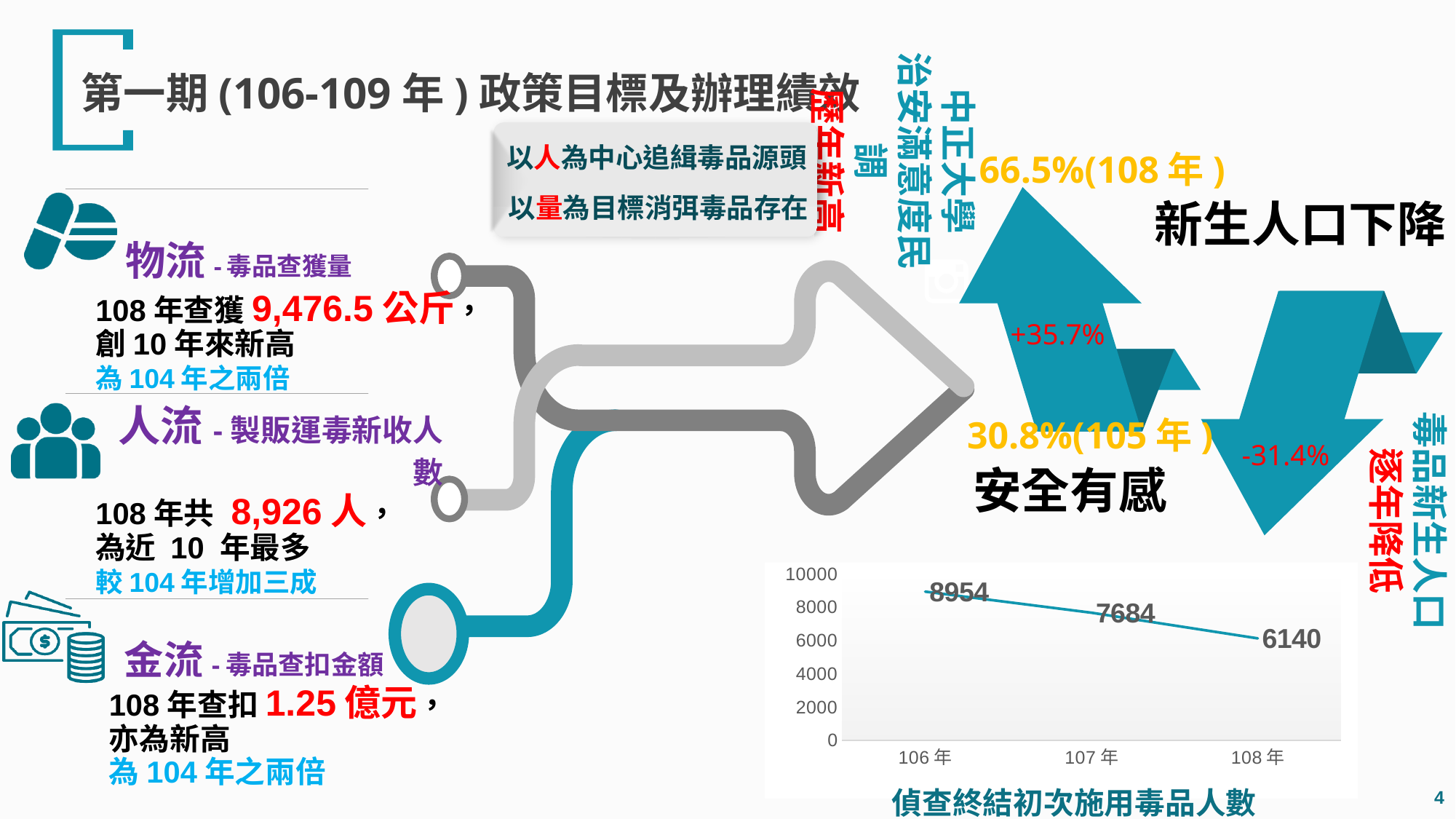
What is the value for 107 年 in the line chart? 7684 What is the value for 108 年 in the line chart? 6140 Is the value for 108 年 in the line chart greater or less than 8000? less How many data points are plotted in the line chart? 3 What is the difference between the values for 106 年 and 108 年 in the line chart? 2814 Which is larger in the line chart, the value for 107 年 or the value for 108 年? 107 年 What is the value for 106 年 in the line chart? 8954 Which year has the lowest value in the line chart? 108 年 What type of chart is shown at the bottom right of the slide? line chart What is the difference between the values for 106 年 and 107 年 in the line chart? 1270 Do the values in the line chart rise or fall from 106 年 to 108 年? fall Which year has the highest value in the line chart? 106 年